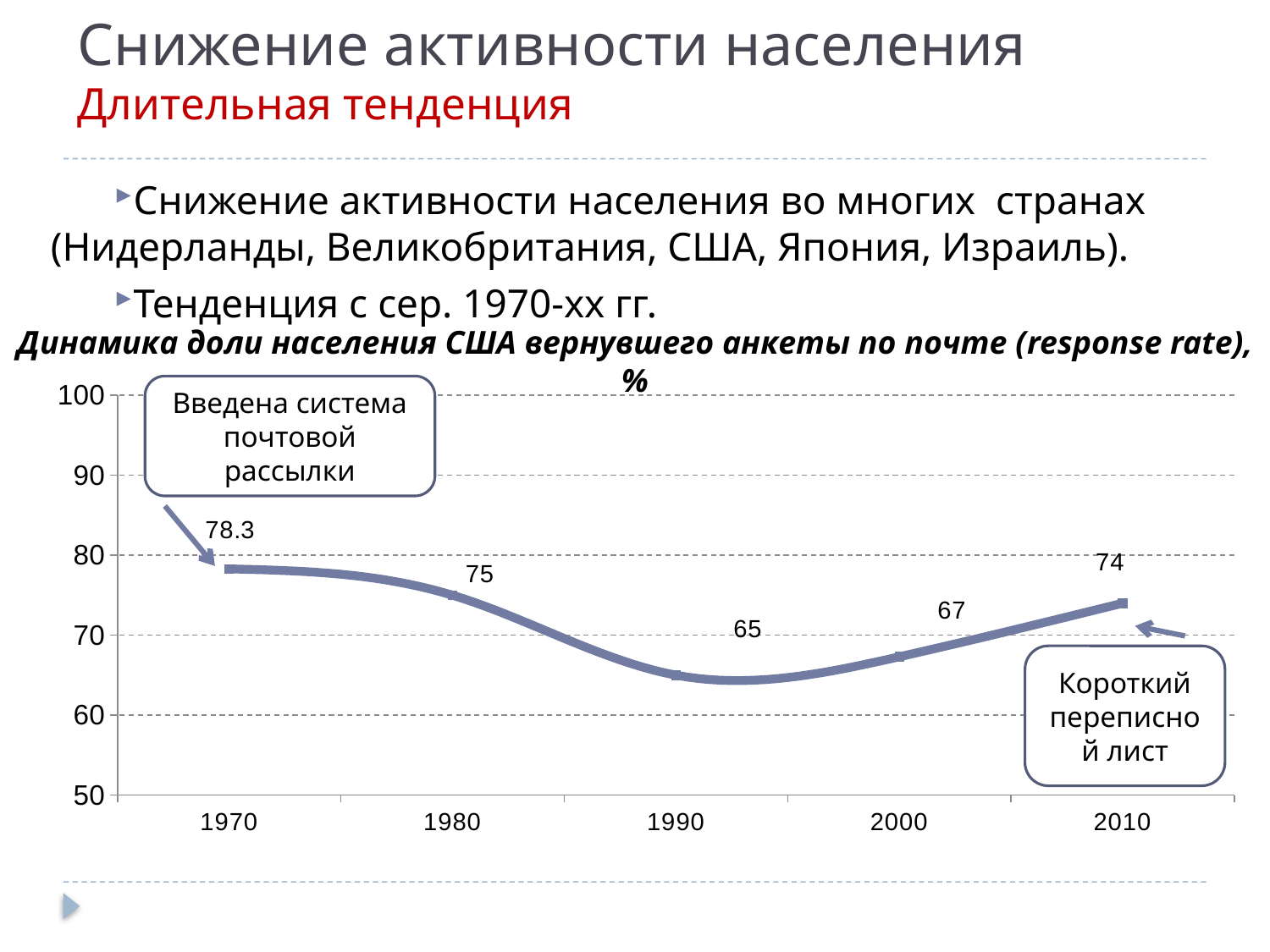
What is the difference between the response rate in 1980 and in 1990? 10 What does the callout near the 1970 point say? Введена система почтовой рассылки What is the response rate value for 1970? 78.3 How many data points are plotted on the chart? 5 What is the response rate value for 1990? 65 What kind of chart is shown on the slide? line chart Which year has the highest response rate? 1970 Is the value for 2000 greater or less than 70? less Does the response rate rise or fall between 1970 and 1990? fall What is the response rate value for 2010? 74 Which year has the lowest response rate? 1990 Which is larger, the response rate in 2000 or in 2010? 2010